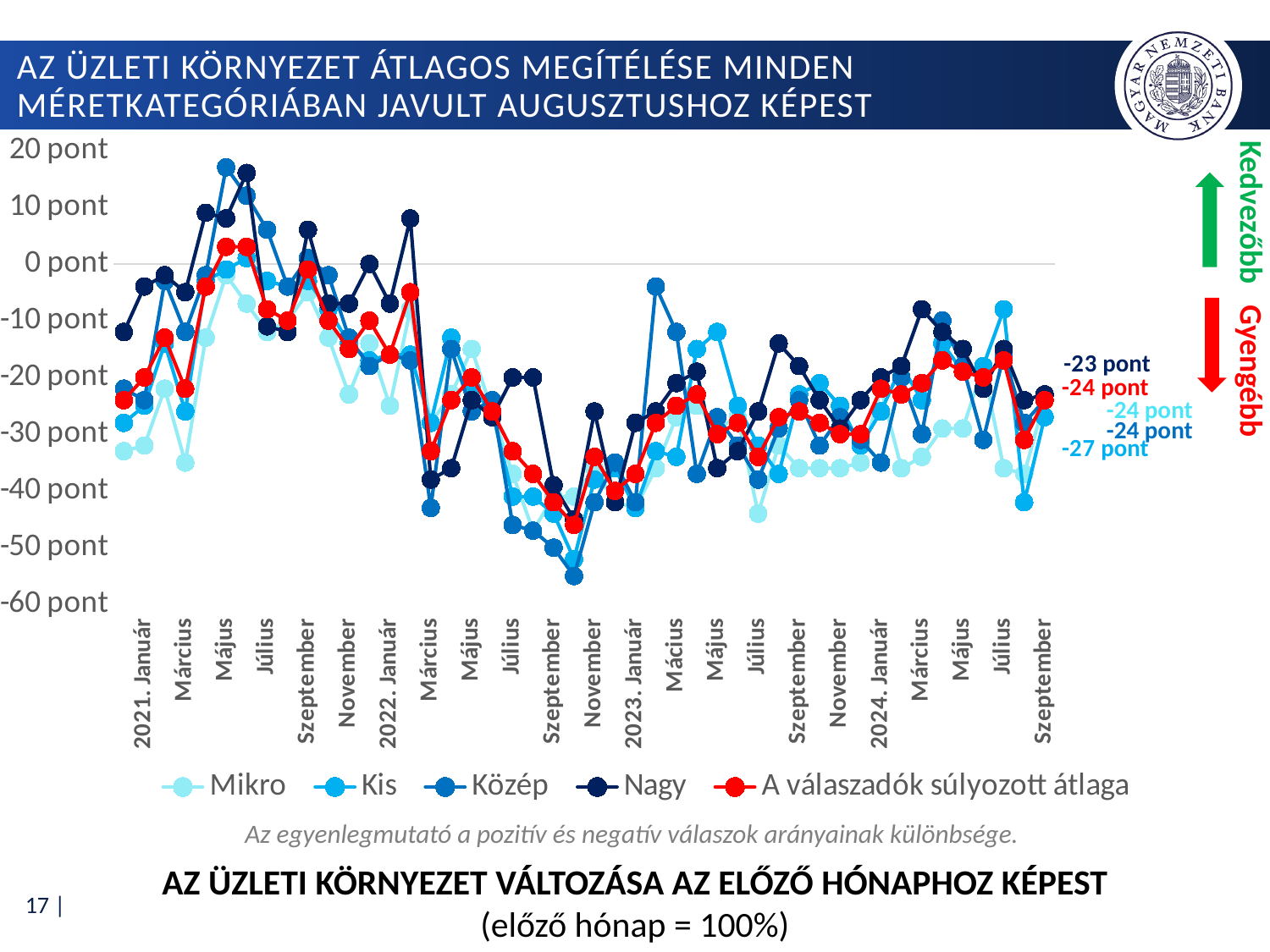
What is the latest value labelled for 'A válaszadók súlyozott átlaga'? -24 pont What is the latest (2024 September) value labelled for the Nagy series? -23 pont Which series is drawn in red in the chart? A válaszadók súlyozott átlaga How many series does the legend list? 5 Which series has the lowest labelled value at the end of the chart? Kis What kind of chart is shown on the slide? line chart Which series has the highest labelled value at the end of the chart? Nagy At the end of the chart, which is larger: the value for Nagy or the value for Kis? Nagy What is the difference between the end-of-chart values of Nagy (-23 pont) and Kis (-27 pont)? 4 pont Is the value for Kis in 2022 Szeptember greater or less than -40 pont? less What is the latest value labelled for the Kis series? -27 pont Does the weighted average ('A válaszadók súlyozott átlaga') rise or fall from 2021 Január to 2021 Május? rise